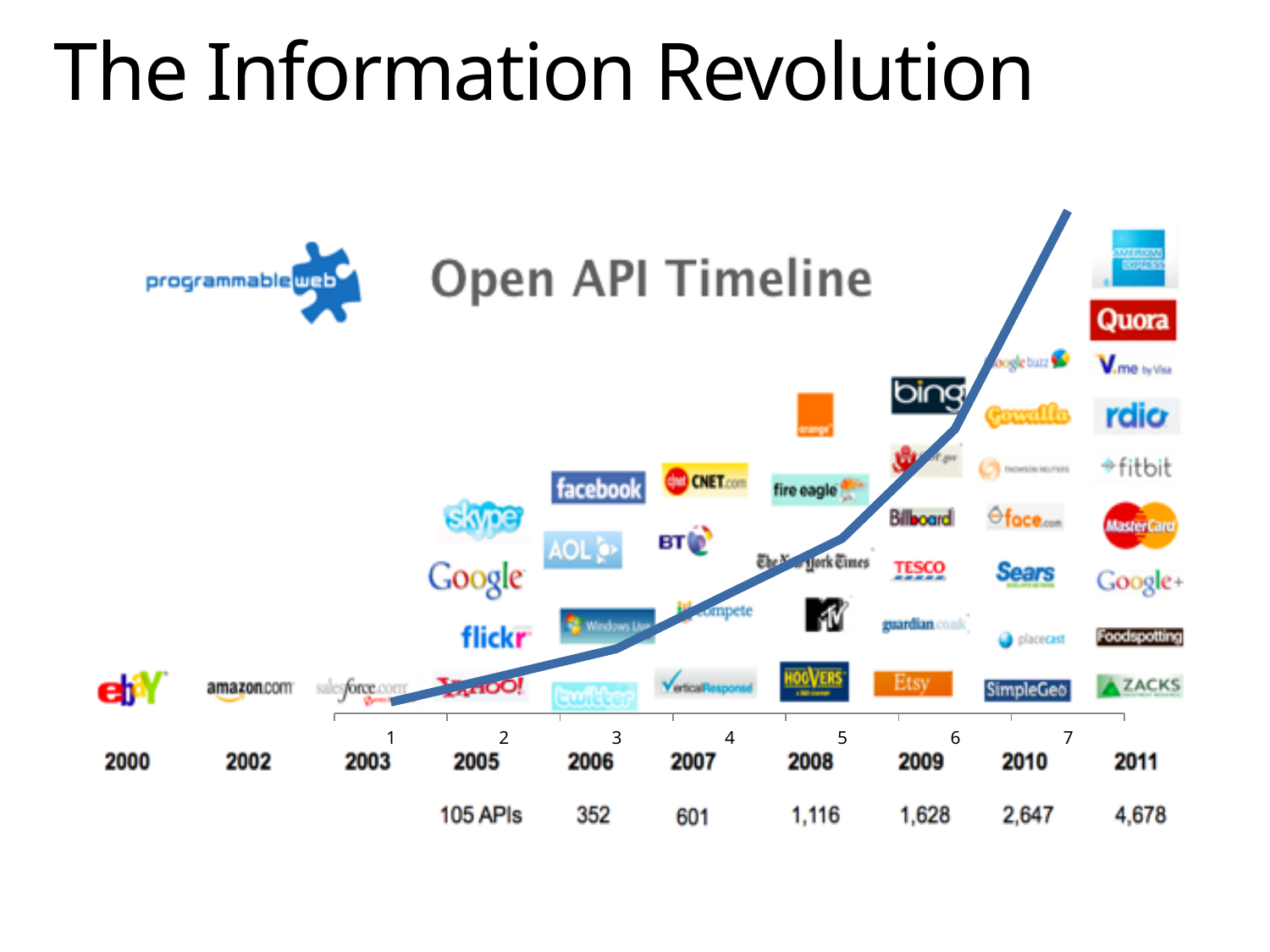
What is the title of the timeline image? Open API Timeline How many points are plotted on the line chart (x-axis ticks 1 to 7)? 7 What is the number of APIs shown for 2008? 1,116 Does the line rise or fall from left to right along the x axis? rises What kind of chart is overlaid on the Open API Timeline? line chart What is the difference in the number of APIs between 2011 and 2010? 2,031 What is the number of APIs shown for 2010? 2,647 Which year has more APIs, 2007 or 2009? 2009 What is the number of APIs shown for 2011? 4,678 Which year has the lowest number of APIs among those with a printed count? 2005 Which year has the highest number of APIs? 2011 How many APIs are listed for 2005? 105 APIs